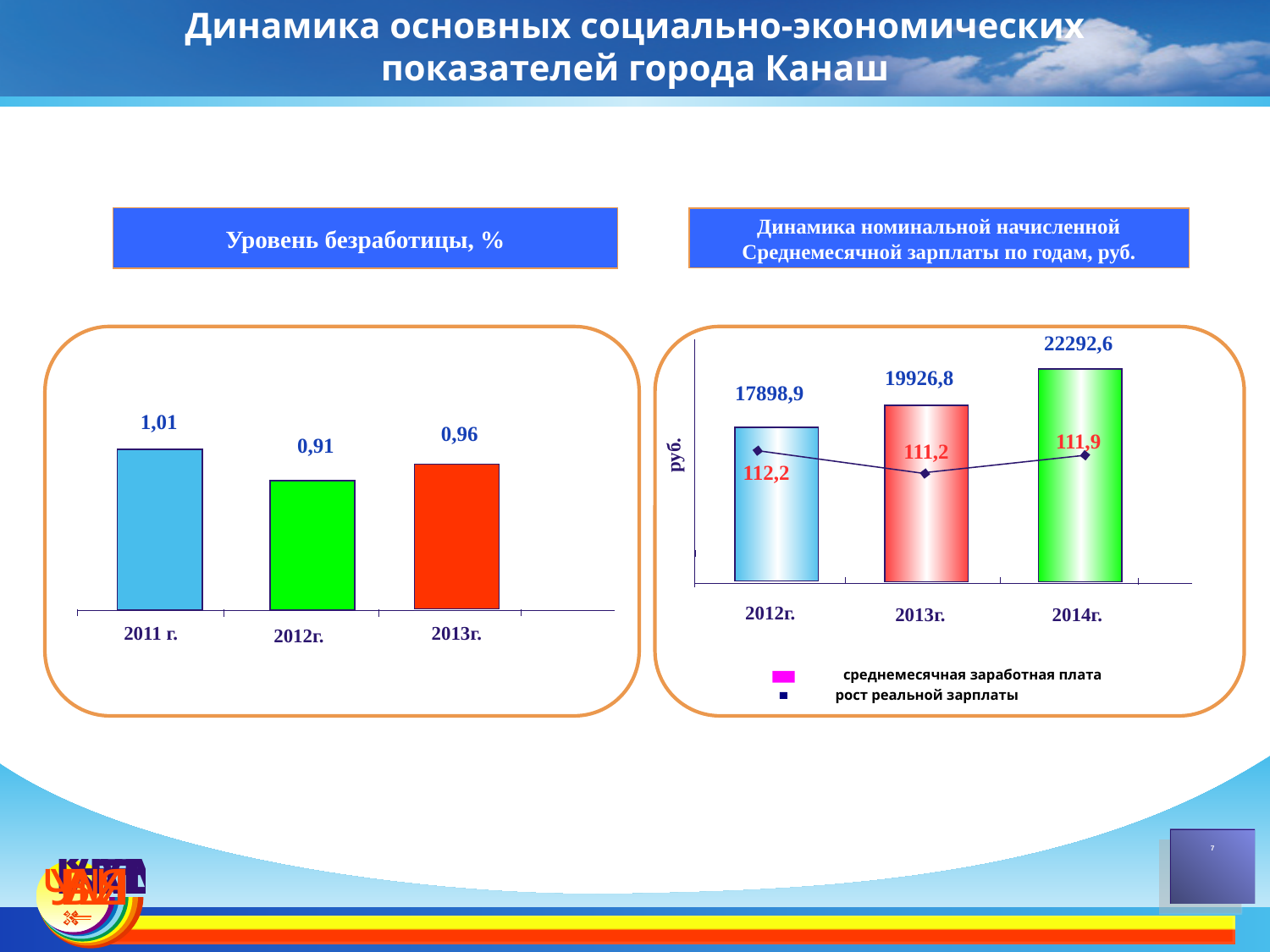
In the chart 'Уровень безработицы, %', how many years are shown? 3 In the chart 'Динамика номинальной начисленной Среднемесячной зарплаты по годам, руб.', how many series does the legend list? 2 In the chart 'Динамика номинальной начисленной Среднемесячной зарплаты по годам, руб.', which year has the highest average monthly salary? 2014г. In the chart 'Уровень безработицы, %', which is larger, the value for 2012г. or 2013г.? 2013г. In the chart 'Динамика номинальной начисленной Среднемесячной зарплаты по годам, руб.', what is the difference in average monthly salary between 2014г. and 2012г.? 4393,7 What kind of chart is 'Уровень безработицы, %'? bar chart In the chart 'Уровень безработицы, %', which year has the lowest value? 2012г. In the chart 'Динамика номинальной начисленной Среднемесячной зарплаты по годам, руб.', do the average monthly salary bars rise or fall from 2012г. to 2014г.? rise In the chart 'Уровень безработицы, %', what is the difference between the values for 2011 г. and 2012г.? 0,10 In the chart 'Динамика номинальной начисленной Среднемесячной зарплаты по годам, руб.', what is the value of 'рост реальной зарплаты' for 2012г.? 112,2 In the chart 'Динамика номинальной начисленной Среднемесячной зарплаты по годам, руб.', what is the average monthly salary for 2013г.? 19926,8 In the chart 'Уровень безработицы, %', what is the value for 2011 г.? 1,01